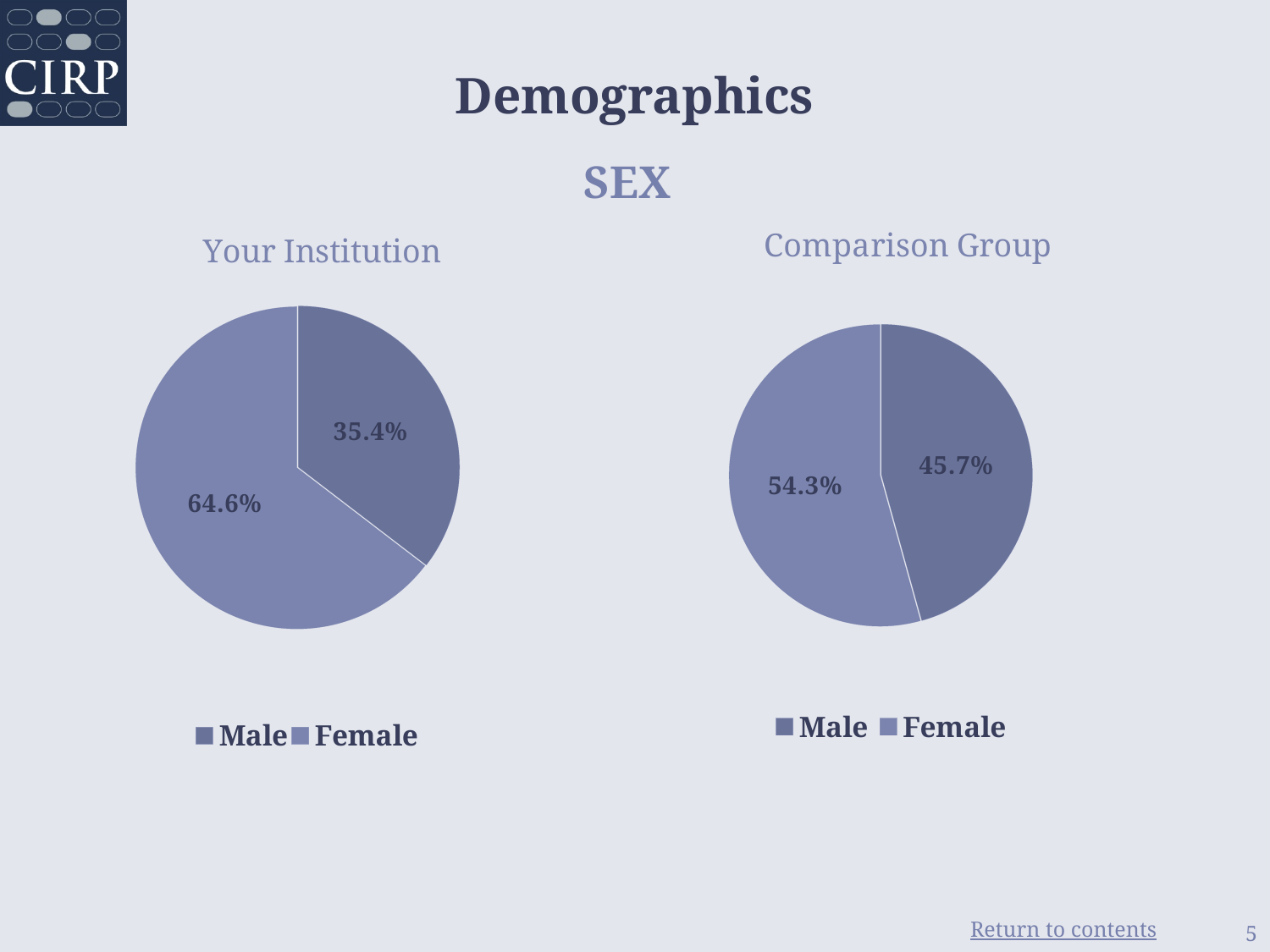
What kind of chart is the Your Institution chart? Pie chart In the Comparison Group chart, what is the difference between the Female and Male percentages? 8.6% Is the Male share larger in the Your Institution chart or the Comparison Group chart? Comparison Group How many slices does the Comparison Group pie chart have? 2 How many entries does the legend of the Your Institution chart list? 2 In the Your Institution chart, what percentage is Male? 35.4% In the Comparison Group chart, what percentage is Female? 54.3% In the Comparison Group chart, what percentage is Male? 45.7% In the Your Institution chart, what is the difference between the Female and Male percentages? 29.2% In the Comparison Group chart, which category has the smallest share? Male In the Your Institution chart, what percentage is Female? 64.6% In the Your Institution chart, which category has the largest share? Female